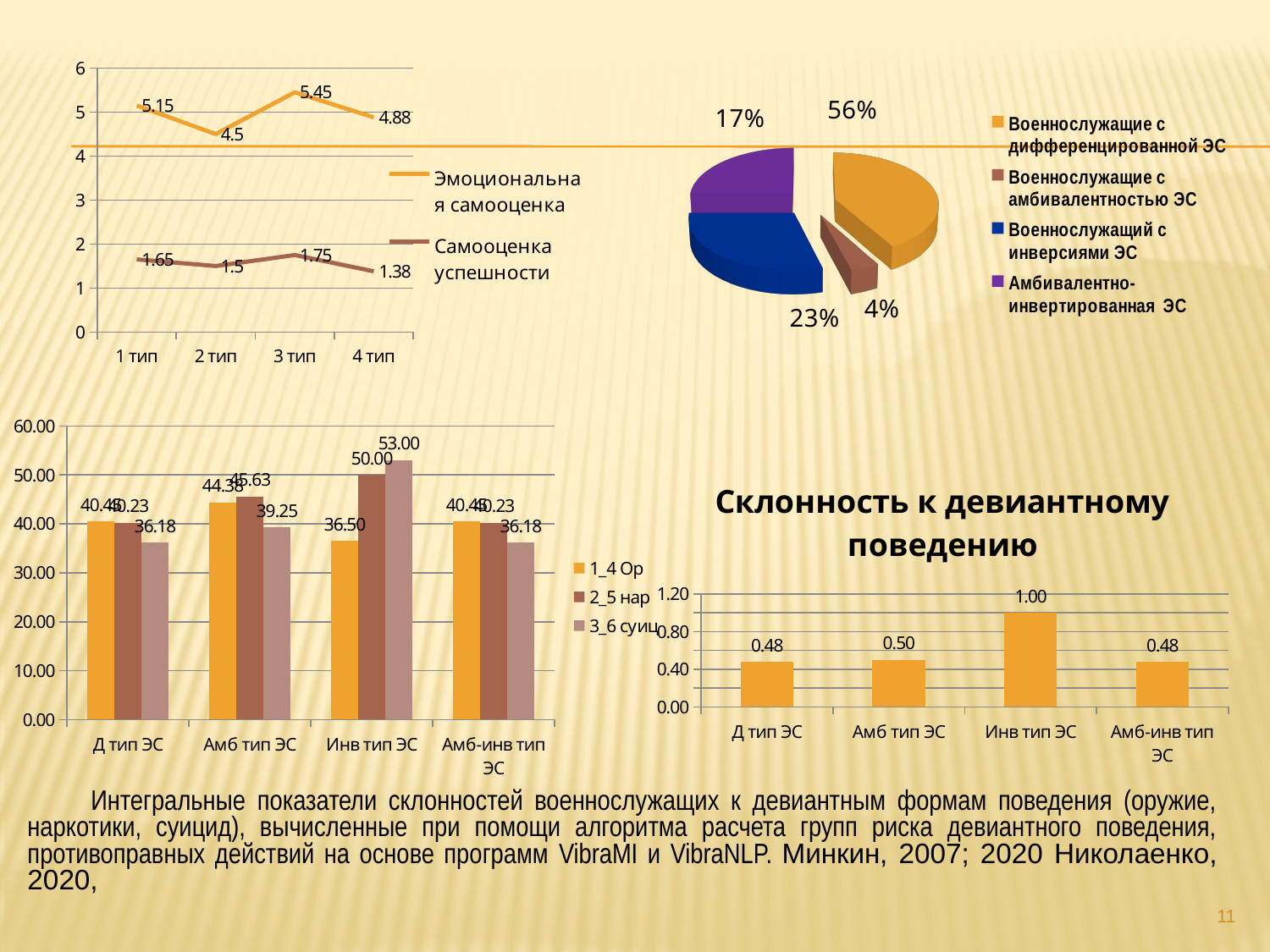
In the chart titled Склонность к девиантному поведению, which category has the highest value? Инв тип ЭС In the top-right pie chart, what share is Военнослужащие с дифференцированной ЭС? 56% In the bottom-left bar chart, which is larger for Инв тип ЭС: 1_4 Ор or 2_5 нар? 2_5 нар In the top-right pie chart, which slice is the smallest? Военнослужащие с амбивалентностью ЭС In the top-left line chart, what is the value of Эмоциональная самооценка for 3 тип? 5.45 In the top-left line chart, what is the value of Самооценка успешности for 4 тип? 1.38 In the chart titled Склонность к девиантному поведению, what is the value for Амб тип ЭС? 0.50 In the top-left line chart, which category has the lowest value for Эмоциональная самооценка? 2 тип In the top-left line chart, what is the difference between Эмоциональная самооценка and Самооценка успешности for 1 тип? 3.5 In the bottom-left bar chart, what is the value of 1_4 Ор for Амб тип ЭС? 44.38 How many series does the legend of the top-left line chart list? 2 In the bottom-left bar chart, what is the value of 3_6 суиц for Инв тип ЭС? 53.00